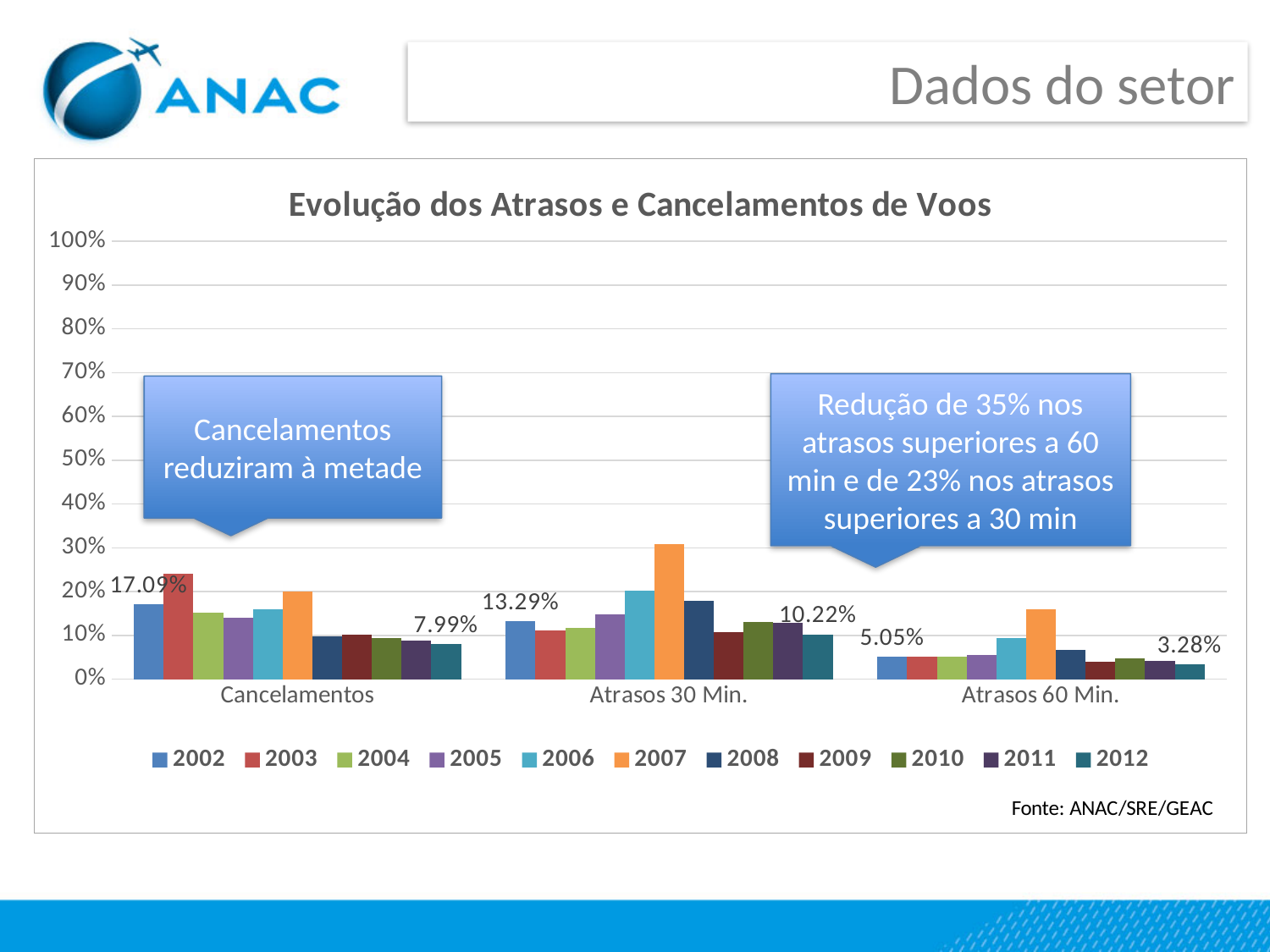
Which year has the highest value in the Atrasos 30 Min. category? 2007 How many series does the legend list? 11 What is the difference between the 2002 and 2012 values in the Atrasos 30 Min. category? 3.07% What is the value for 2012 in the Cancelamentos category? 7.99% What is the value for 2002 in the Cancelamentos category? 17.09% What is the value for 2012 in the Atrasos 60 Min. category? 3.28% Is the value for 2007 in the Atrasos 30 Min. category greater or less than 20%? greater What is the value for 2002 in the Atrasos 30 Min. category? 13.29% What kind of chart is shown on the slide? Bar chart What is the title of the chart? Evolução dos Atrasos e Cancelamentos de Voos What is the difference between the 2002 and 2012 values in the Cancelamentos category? 9.10% How many categories are shown on the x axis? 3